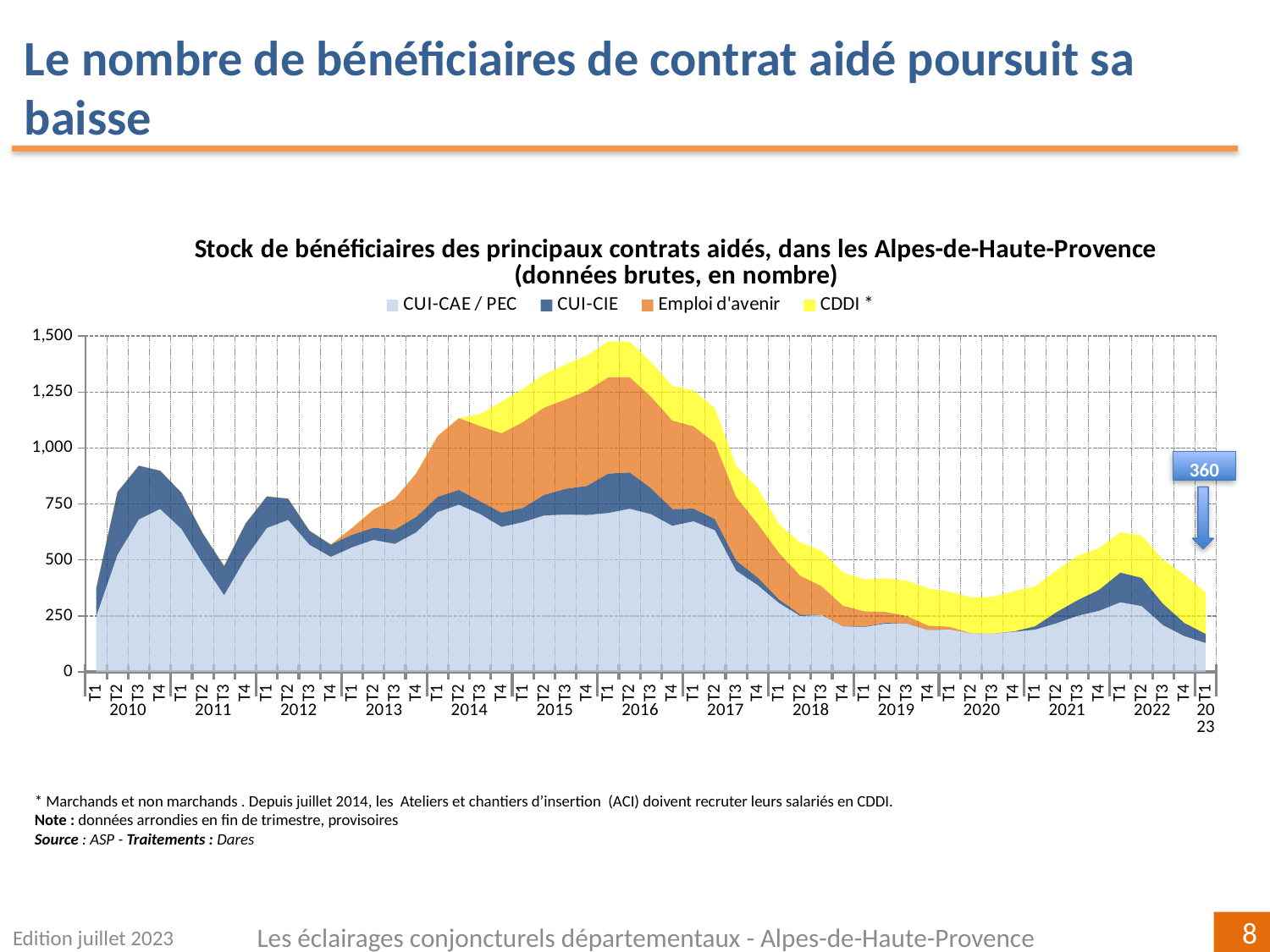
Is the total stock of beneficiaries in T2 2014 greater or less than 1,000? greater Is the total stock of beneficiaries in T1 2021 greater or less than 500? less Which colour represents the CDDI * series? Yellow How many years are labelled on the x axis? 14 Is the total stock of beneficiaries in T1 2010 greater or less than 500? less Which series is at the bottom of the stacked areas? CUI-CAE / PEC Does the total stock of beneficiaries rise or fall between 2016 and 2018? Fall What value does the callout label give for the latest point (T1 2023)? 360 How many series does the legend list? 4 What kind of chart is shown on the slide? Stacked area chart In which year does the total stock of beneficiaries reach its highest level? 2016